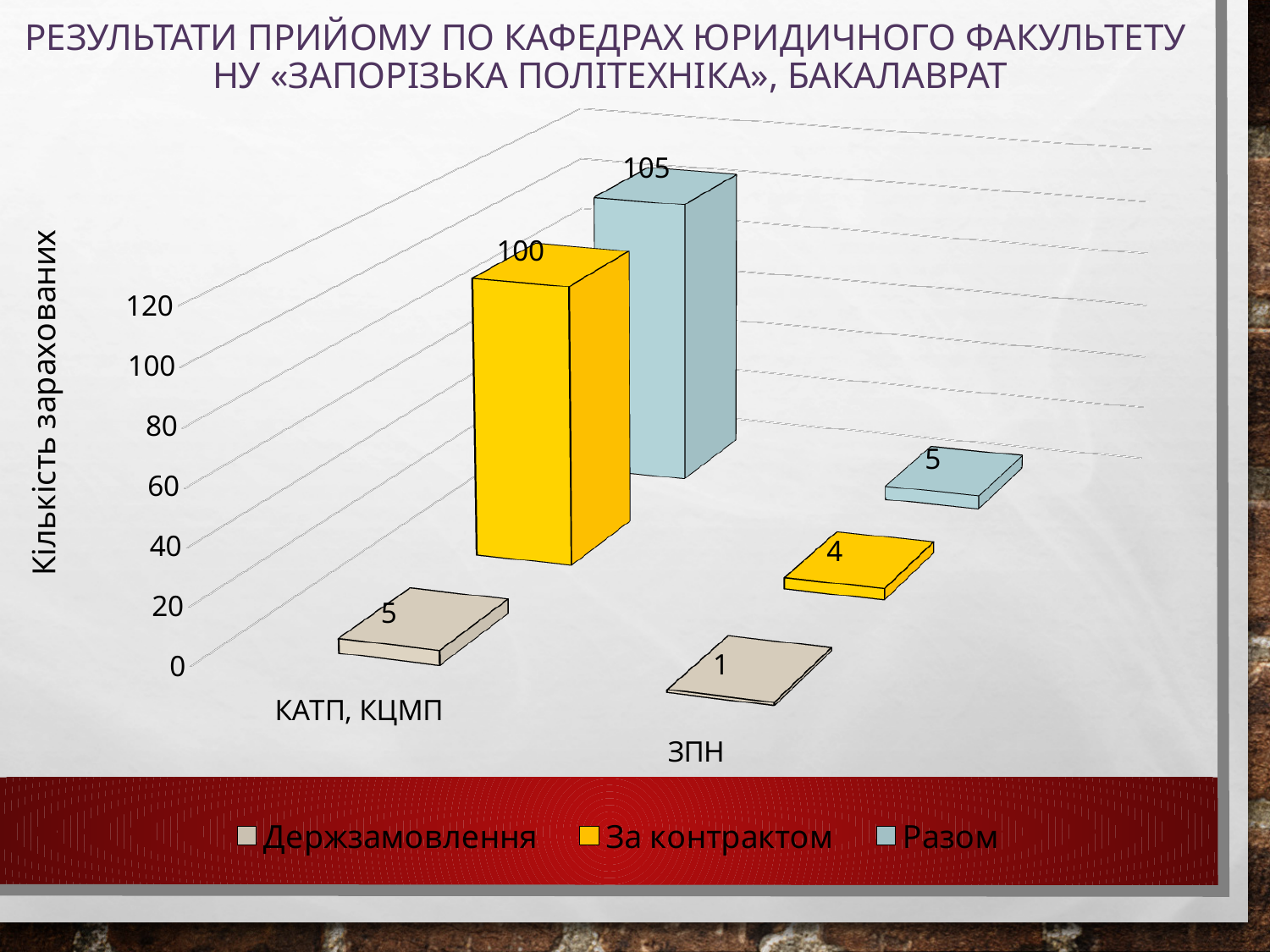
What is the value of Разом for КАТП, КЦМП? 105 Which category has the highest Разом value? КАТП, КЦМП Which category has the lowest Держзамовлення value? ЗПН What is the value of За контрактом for ЗПН? 4 How many series does the legend list? 3 What is the value of Держзамовлення for ЗПН? 1 What is the label of the vertical axis? Кількість зарахованих What kind of chart is shown on the slide? Bar chart Which is larger for КАТП, КЦМП: Держзамовлення or За контрактом? За контрактом How many categories are shown on the x axis? 2 What is the difference between the За контрактом values for КАТП, КЦМП and ЗПН? 96 What is the value of За контрактом for КАТП, КЦМП? 100